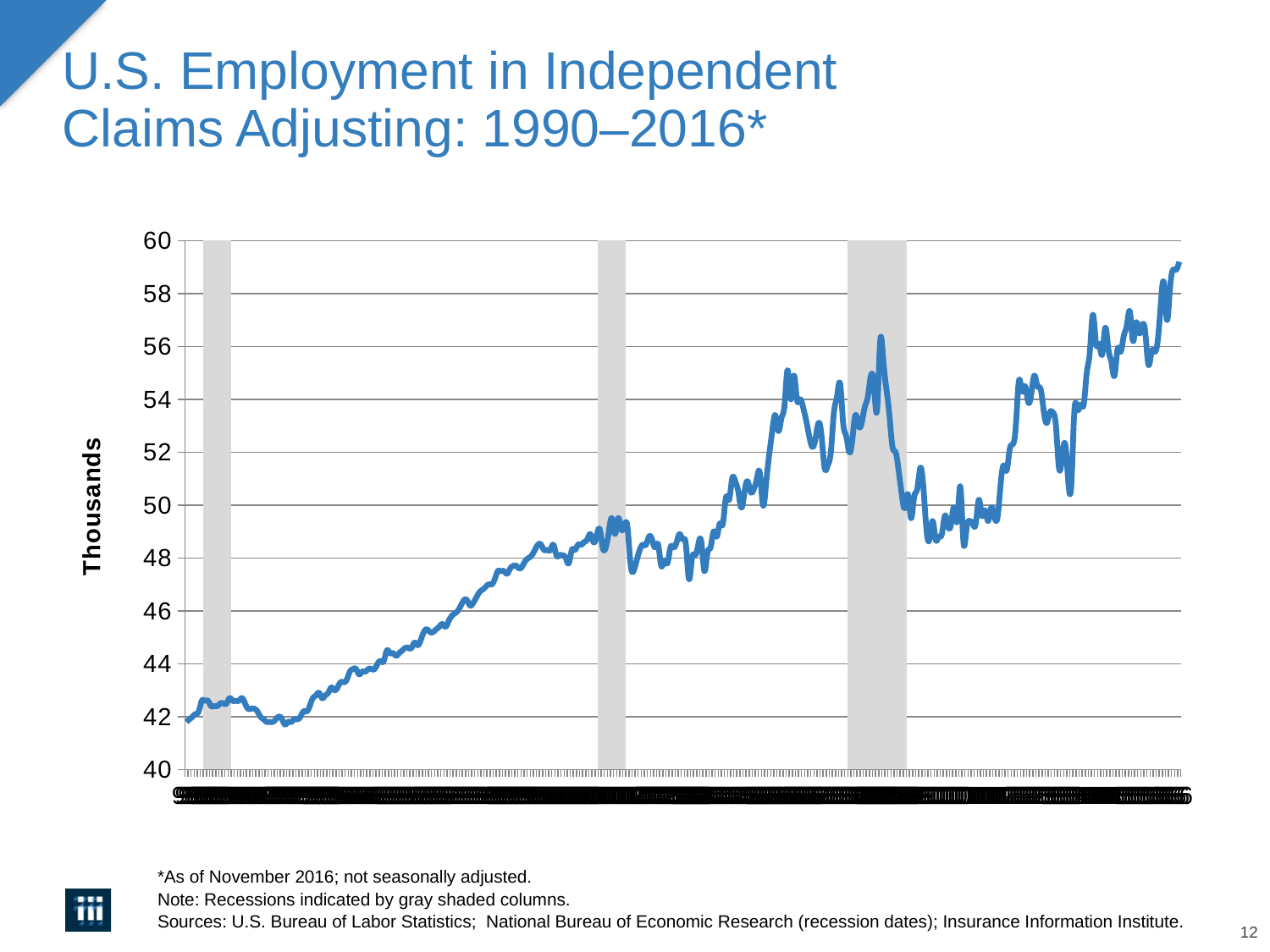
What is the label on the vertical axis? Thousands Is the value at the end of the series (right end of the line) greater or less than 58? greater Is the value at the start of the series (left end of the line) greater or less than 44? less How many gray shaded recession columns are shown on the chart? 3 Is the highest point of the line greater or less than 60? less Overall, do the values rise or fall from the left of the chart to the right? rise Is the value at the end of the series greater or less than the value at the start of the series? greater What kind of chart is shown on the slide? line chart